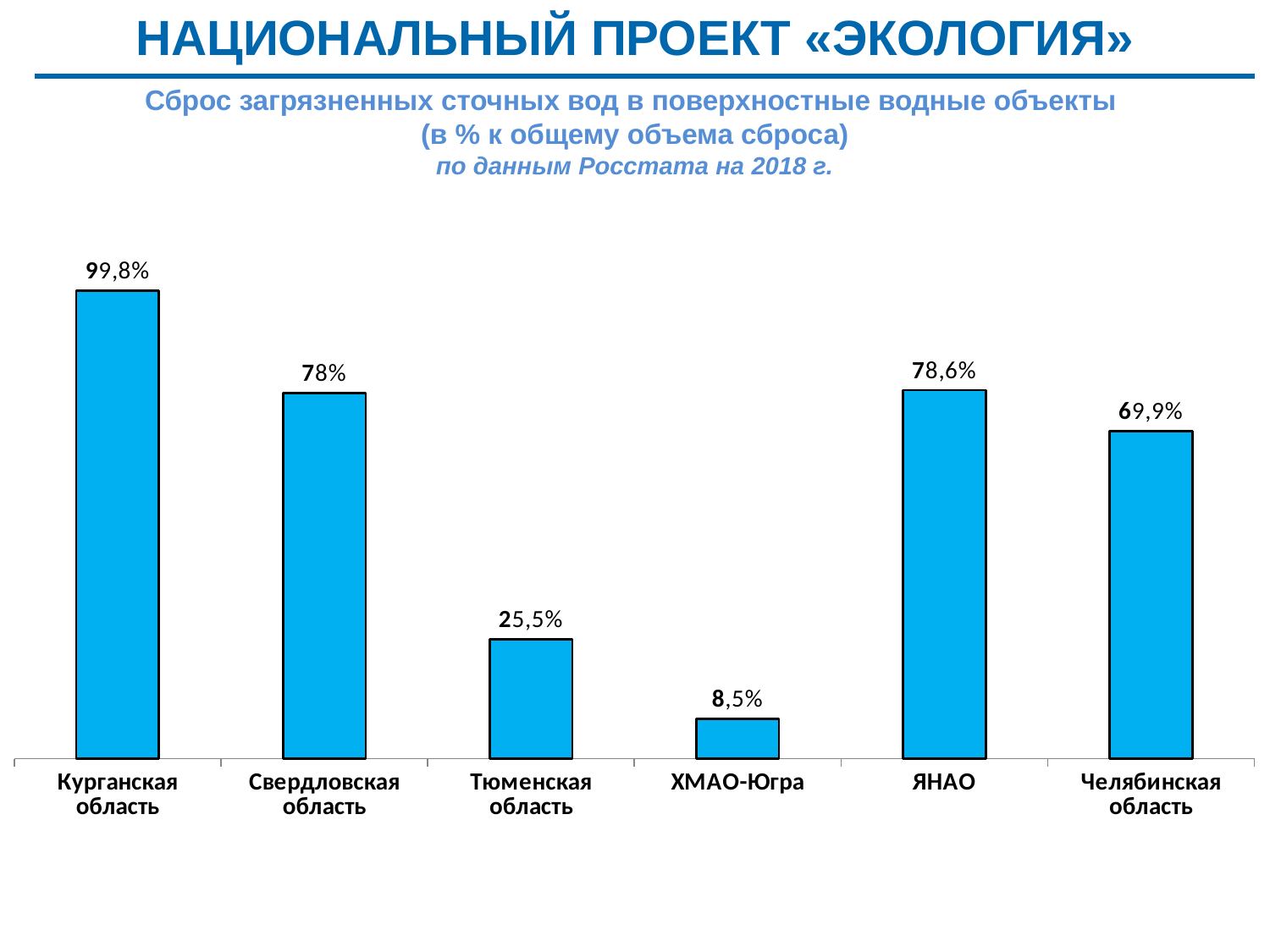
What is the value for Челябинская область? 69,9% According to the subtitle, for which year are the Rosstat data shown? 2018 How many regions are shown in the chart? 6 Which region has the highest value? Курганская область Which region has the lowest value? ХМАО-Югра What kind of chart is shown on the slide? Bar chart What is the value for Курганская область? 99,8% What is the difference between the values for Курганская область and ХМАО-Югра? 91,3 percentage points What is the value for Тюменская область? 25,5% What is the value for ХМАО-Югра? 8,5% What is the difference between the values for ЯНАО and Челябинская область? 8,7 percentage points Which is larger, the value for Свердловская область or the value for Тюменская область? Свердловская область